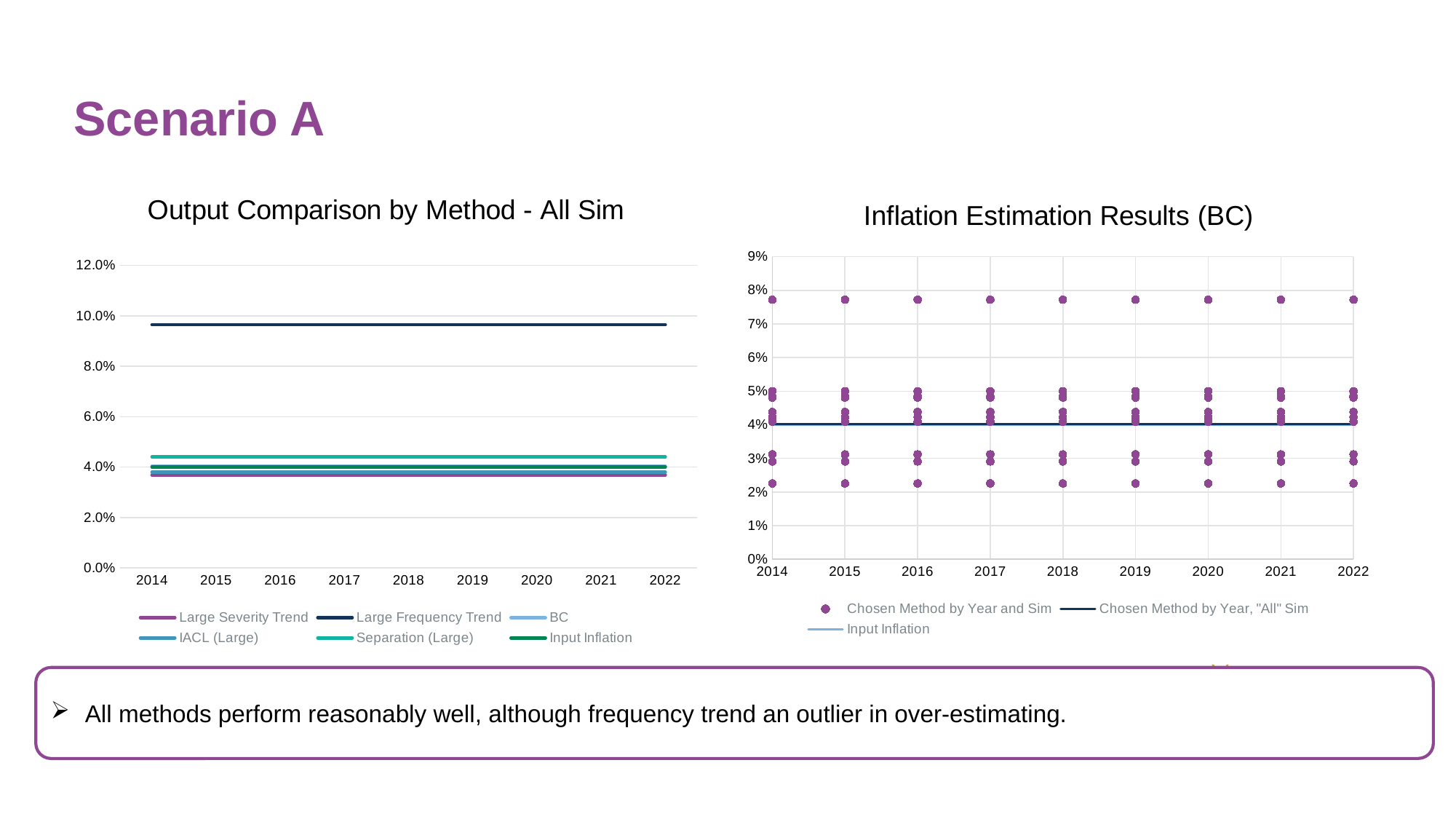
What kind of chart is the 'Output Comparison by Method - All Sim' chart? line chart In the 'Inflation Estimation Results (BC)' chart, is the highest 'Chosen Method by Year and Sim' point in 2014 greater or less than 7%? greater What is the title of the chart on the right side of the slide? Inflation Estimation Results (BC) How many series does the legend of the 'Output Comparison by Method - All Sim' chart list? 6 In the 'Output Comparison by Method - All Sim' chart, is the value for Large Frequency Trend in 2018 greater or less than 8.0%? greater How many years are shown on the x axis of the 'Output Comparison by Method - All Sim' chart? 9 In the 'Output Comparison by Method - All Sim' chart, which is larger in 2020: Large Frequency Trend or Separation (Large)? Large Frequency Trend In the 'Output Comparison by Method - All Sim' chart, do the Large Frequency Trend values rise, fall, or stay flat from 2014 to 2022? stay flat How many entries does the legend of the 'Inflation Estimation Results (BC)' chart list? 3 In the 'Inflation Estimation Results (BC)' chart, is the lowest 'Chosen Method by Year and Sim' point in 2022 greater or less than 3%? less In the 'Output Comparison by Method - All Sim' chart, which series has the highest values? Large Frequency Trend